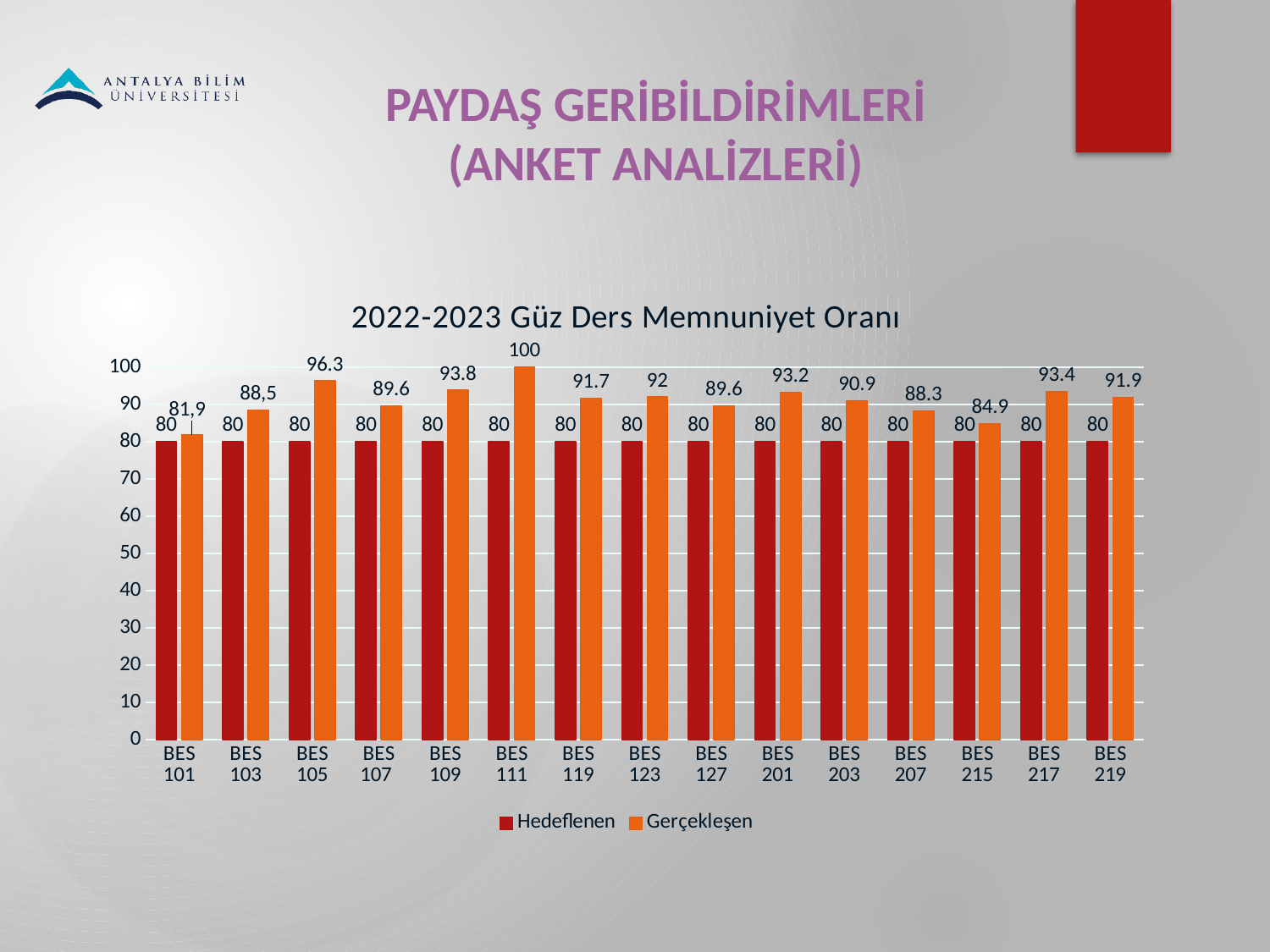
What is the Gerçekleşen value for BES 105? 96.3 Which course has the lowest Gerçekleşen value? BES 101 Which course has the highest Gerçekleşen value? BES 111 How many series does the legend list? 2 What is the Gerçekleşen value for BES 215? 84.9 How many courses are shown on the x axis? 15 What is the Gerçekleşen value for BES 111? 100 What is the difference between the Gerçekleşen and Hedeflenen values for BES 111? 20 Which has a higher Gerçekleşen value, BES 105 or BES 109? BES 105 What is the Hedeflenen value for BES 203? 80 What kind of chart is shown? Bar chart What is the title of the chart? 2022-2023 Güz Ders Memnuniyet Oranı